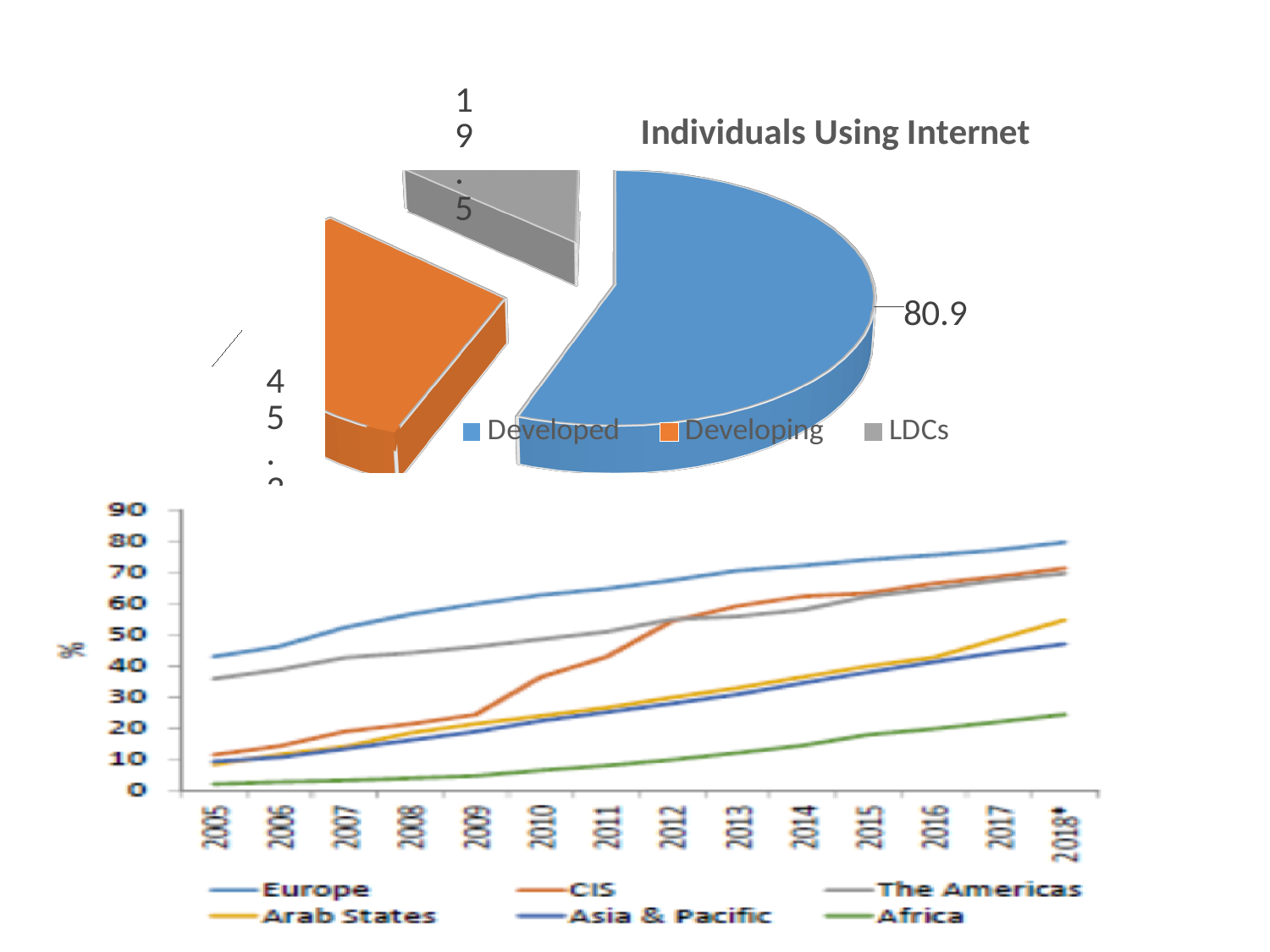
On the lower line chart, how many series does the legend list? 6 On the pie chart titled 'Individuals Using Internet', what is the value for Developed? 80.9 On the lower line chart, is the value for Africa in 2005 greater or less than 10? less On the pie chart titled 'Individuals Using Internet', how many categories does the legend list? 3 What kind of chart is the lower chart on the slide? Line chart On the pie chart titled 'Individuals Using Internet', which category has the largest slice? Developed On the pie chart titled 'Individuals Using Internet', what is the value for LDCs? 19.5 On the lower line chart, which region has the highest value in 2018*? Europe On the lower line chart, how many years are shown on the x axis? 14 On the lower line chart, does the Europe line rise or fall from 2005 to 2018*? Rise On the pie chart titled 'Individuals Using Internet', which category has the smallest slice? LDCs On the pie chart titled 'Individuals Using Internet', what is the difference between the Developed and LDCs values? 61.4